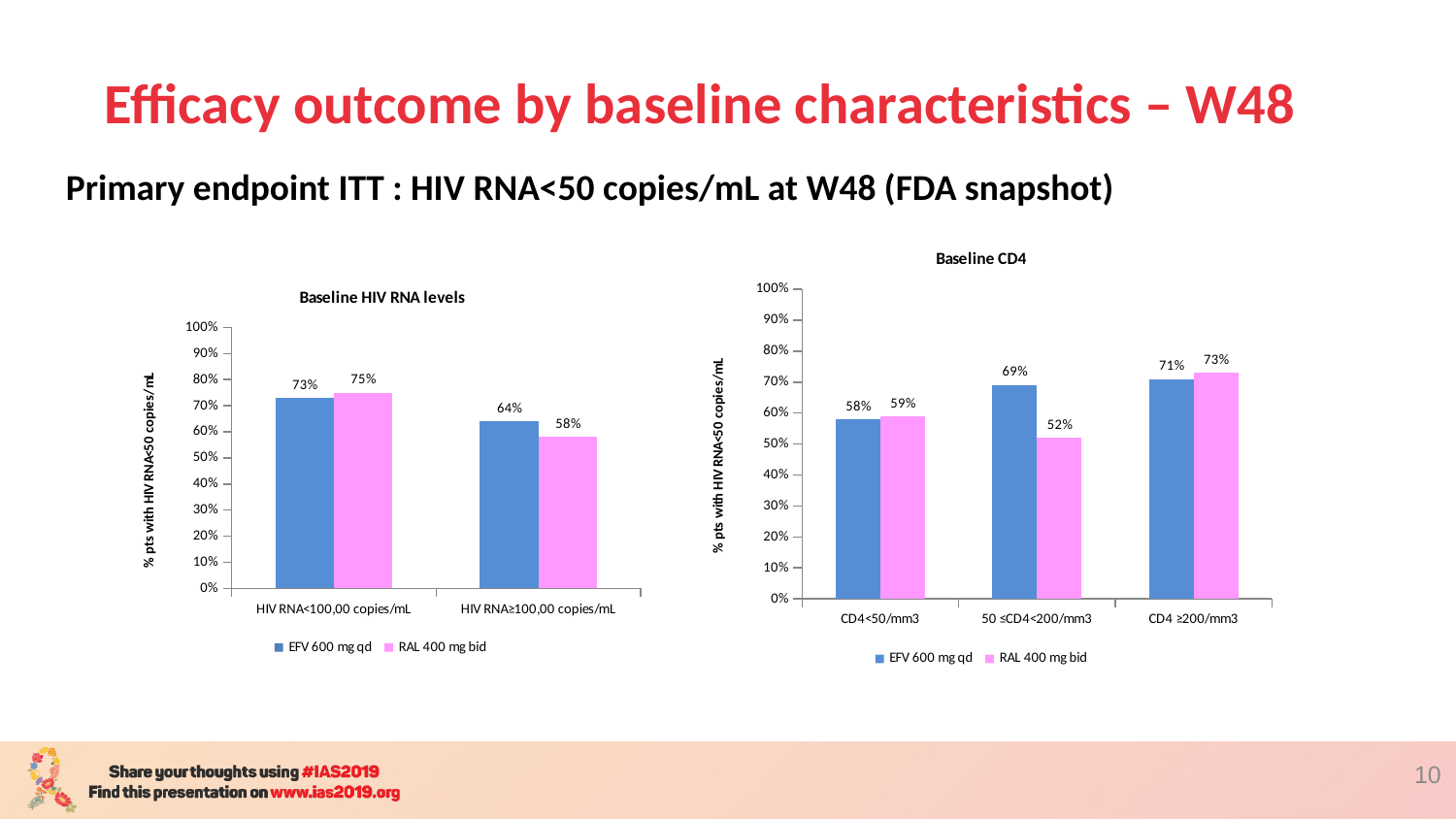
What type of chart is the 'Baseline CD4' chart? Bar chart In the 'Baseline HIV RNA levels' chart, what is the difference between the EFV 600 mg qd values for the two HIV RNA groups? 9% In the 'Baseline CD4' chart, which category has the lowest value for RAL 400 mg bid? 50 ≤CD4<200/mm3 In the 'Baseline CD4' chart, what is the value for RAL 400 mg bid in the 50 ≤CD4<200/mm3 group? 52% In the 'Baseline CD4' chart, which category has the highest value for EFV 600 mg qd? CD4 ≥200/mm3 In the 'Baseline CD4' chart, what is the difference between EFV 600 mg qd and RAL 400 mg bid in the 50 ≤CD4<200/mm3 group? 17% In the 'Baseline HIV RNA levels' chart, what is the value for EFV 600 mg qd in the HIV RNA<100,00 copies/mL group? 73% How many series does the legend of the 'Baseline HIV RNA levels' chart list? 2 In the 'Baseline HIV RNA levels' chart, what is the value for RAL 400 mg bid in the HIV RNA≥100,00 copies/mL group? 58% In the 'Baseline HIV RNA levels' chart, which is larger in the HIV RNA≥100,00 copies/mL group: EFV 600 mg qd or RAL 400 mg bid? EFV 600 mg qd In the 'Baseline CD4' chart, what is the value for EFV 600 mg qd in the CD4 ≥200/mm3 group? 71% How many categories are shown on the x axis of the 'Baseline CD4' chart? 3